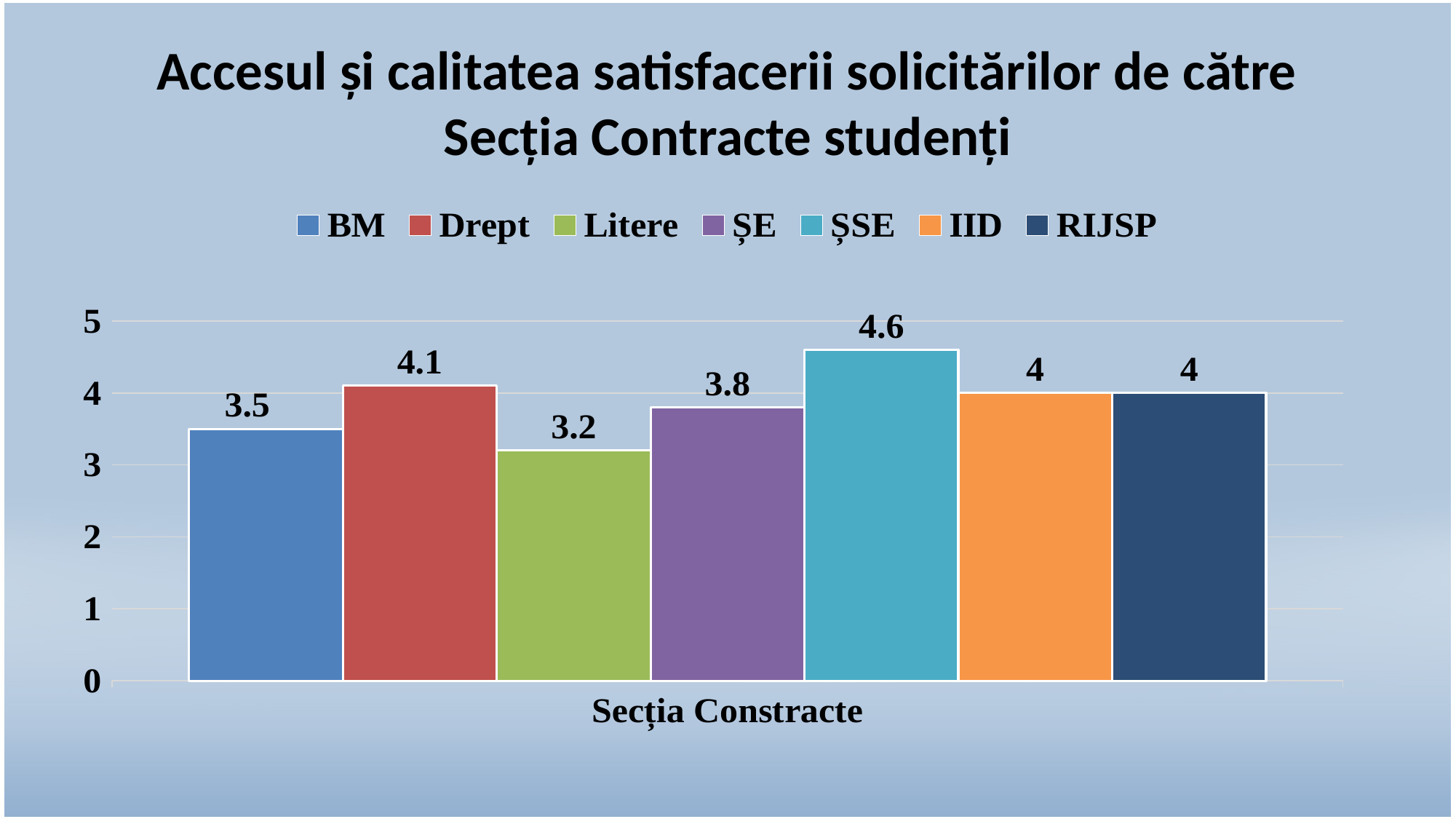
What is the label on the x axis of the chart? Secția Constracte What is the difference between the values for ȘSE and BM? 1.1 What is the value for Litere? 3.2 What is the value for Drept? 4.1 How many bars are plotted in the chart? 7 What is the value for ȘE? 3.8 Is the value for BM greater or less than 4? less Which is larger, the value for Drept or the value for ȘE? Drept How many series does the legend list? 7 Which series has the lowest value? Litere What kind of chart is shown on the slide? bar chart Which series has the highest value? ȘSE